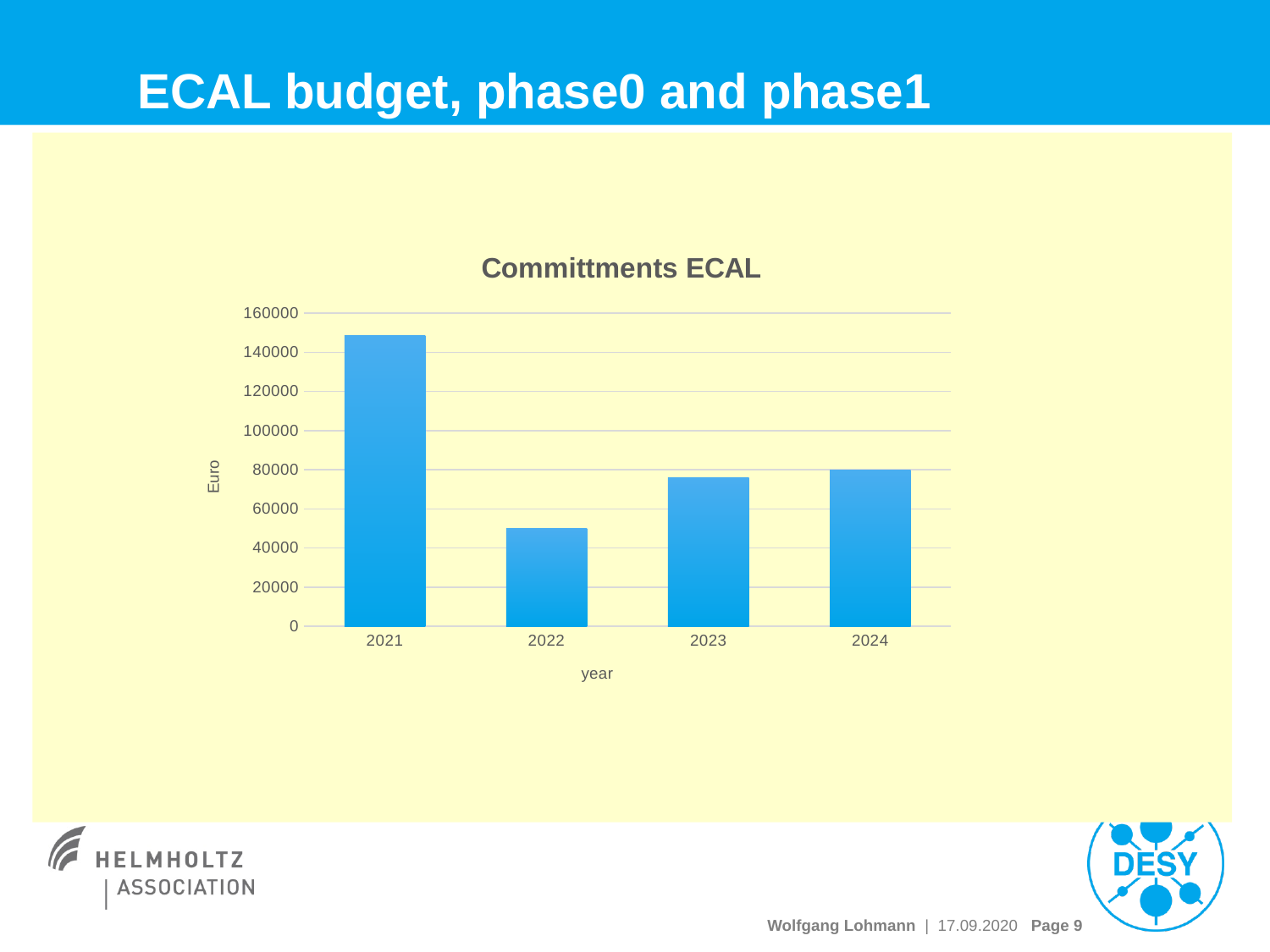
Which year has the larger value, 2021 or 2022? 2021 Is the value for 2024 greater or less than 100000? less Which year has the lowest commitment value? 2022 Does the value rise or fall from 2021 to 2022? fall Is the value for 2023 greater or less than 60000? greater Is the value for 2022 greater or less than 60000? less What kind of chart is shown on the slide? bar chart How many years are shown on the x axis of the chart? 4 Which year has the larger value, 2022 or 2023? 2023 What is the title of the chart? Committments ECAL Which year has the highest commitment value? 2021